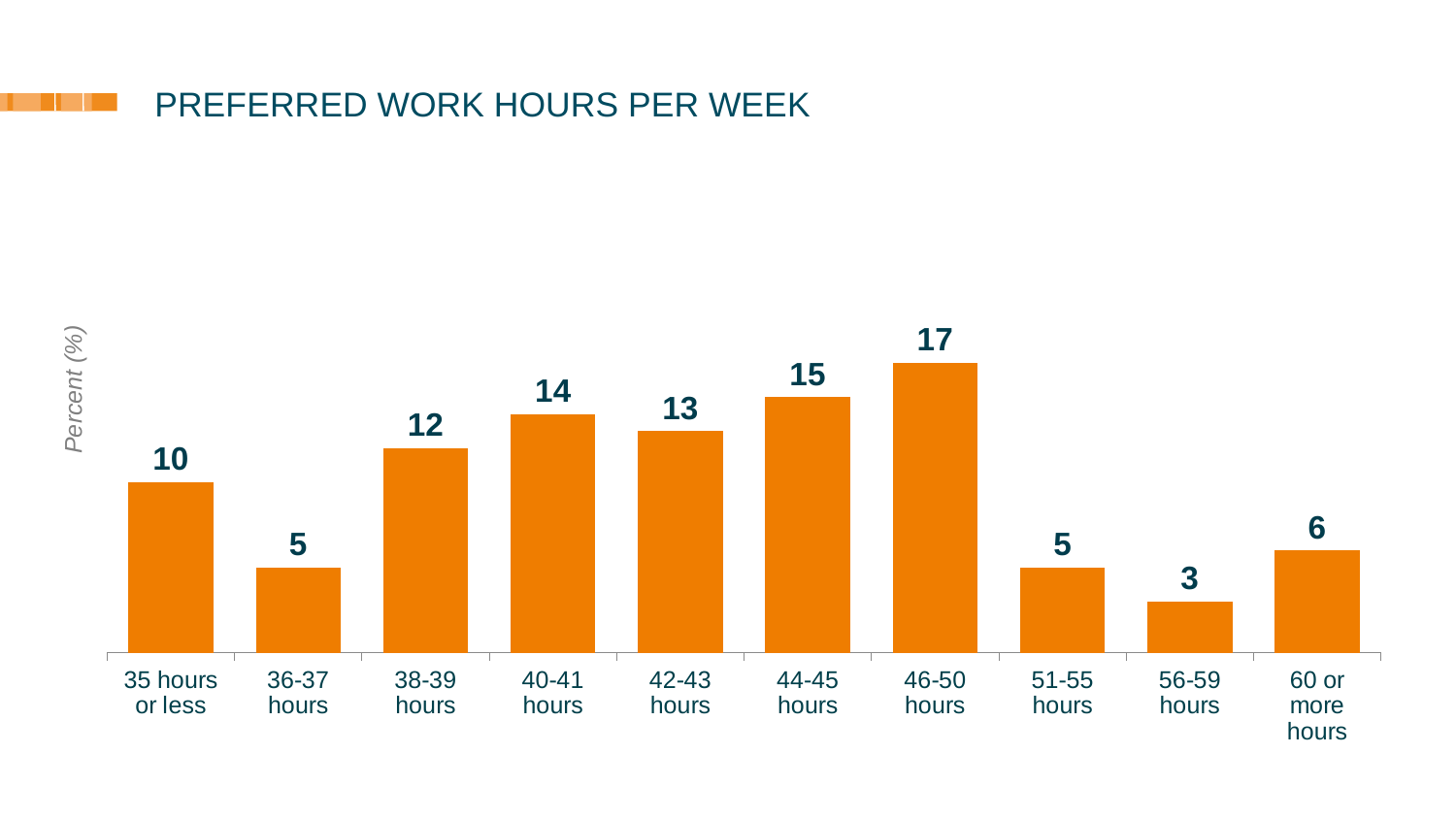
What is the difference between the values for '60 or more hours' and '56-59 hours'? 3 Which category has the lowest value? 56-59 hours What is the value for the '35 hours or less' category? 10 Which is larger, the value for '38-39 hours' or the value for '42-43 hours'? 42-43 hours What kind of chart is shown on the slide? Bar chart How many categories are shown on the x axis? 10 What is the value for '56-59 hours'? 3 Which category has the highest value? 46-50 hours What is the title of the chart? PREFERRED WORK HOURS PER WEEK What is the difference between the values for '46-50 hours' and '40-41 hours'? 3 What percentage of respondents prefer 46-50 hours per week? 17 What is the label on the vertical axis? Percent (%)